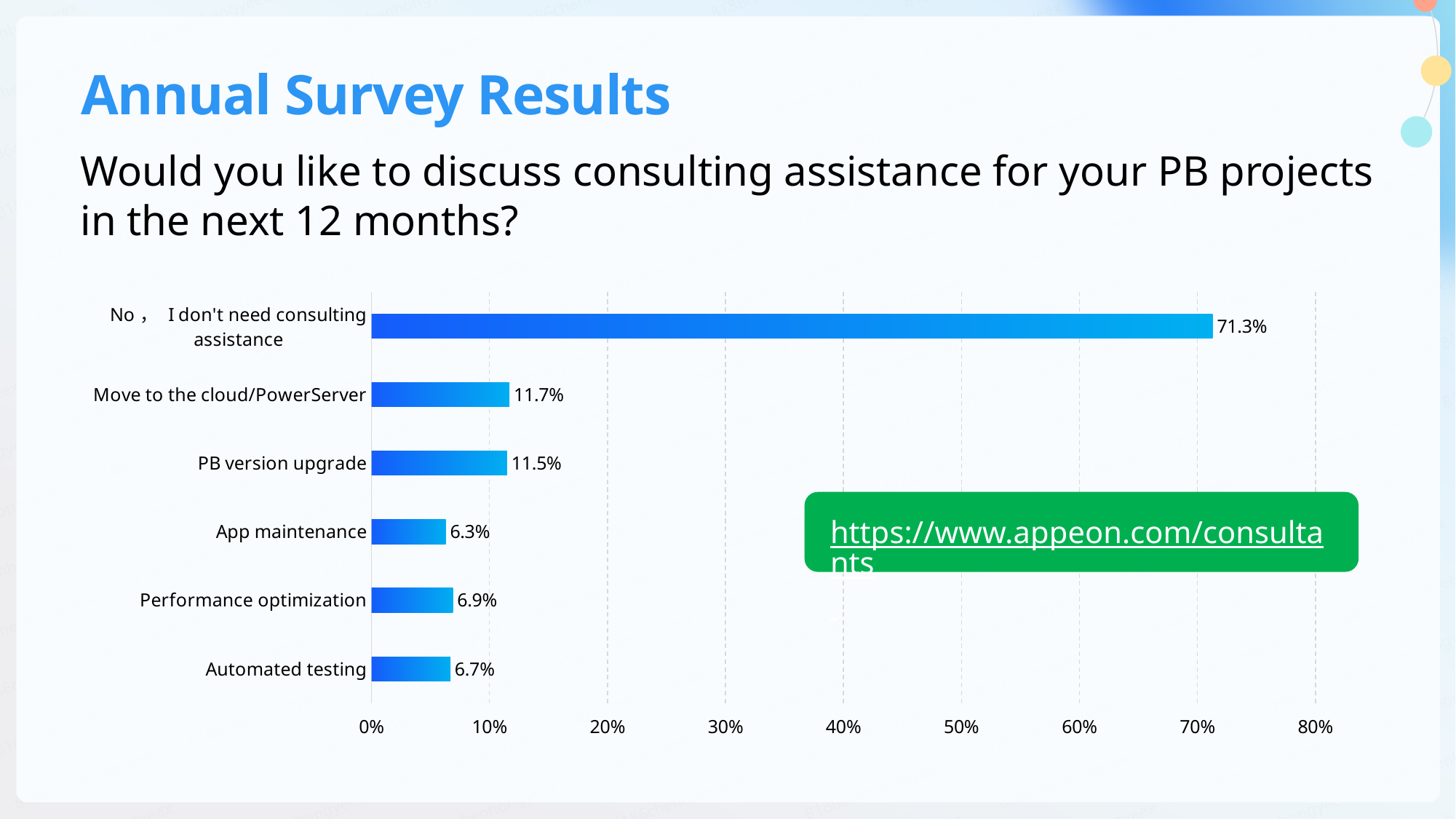
What kind of chart is shown on the slide? Bar chart What is the value for "Automated testing"? 6.7% What is the value for "PB version upgrade"? 11.5% Which is larger, "Performance optimization" or "Automated testing"? Performance optimization Which category has the highest value? No, I don't need consulting assistance What is the difference between "Move to the cloud/PowerServer" and "PB version upgrade"? 0.2% What percentage of respondents answered "No, I don't need consulting assistance"? 71.3% What is the value for "App maintenance"? 6.3% Which category has the lowest value? App maintenance What is the value for "Move to the cloud/PowerServer"? 11.7% Is the value for "No, I don't need consulting assistance" greater or less than 70%? greater How many categories are shown in the chart? 6